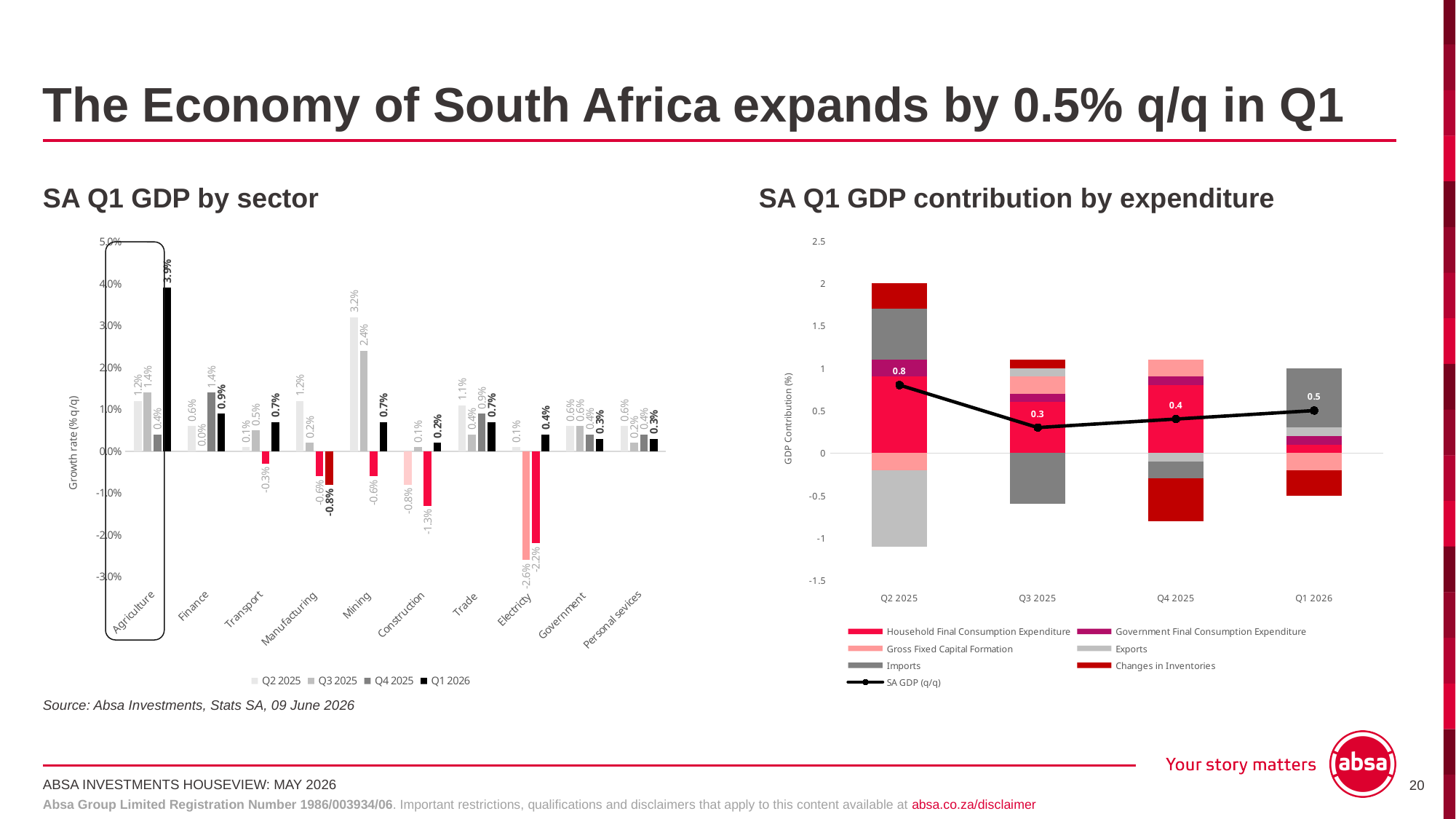
In the 'SA Q1 GDP by sector' chart, which sector has the lowest Q1 2026 growth rate? Manufacturing How many sectors are shown in the 'SA Q1 GDP by sector' chart? 10 In the 'SA Q1 GDP by sector' chart, which is larger for Construction: the Q2 2025 value or the Q4 2025 value? Q2 2025 How many entries does the legend of the 'SA Q1 GDP contribution by expenditure' chart list? 7 In the 'SA Q1 GDP by sector' chart, what is the Q1 2026 growth rate for Agriculture? 3.9% How many series does the legend of the 'SA Q1 GDP by sector' chart list? 4 In the 'SA Q1 GDP by sector' chart, what is the difference between the Q2 2025 and Q3 2025 growth rates for Mining? 0.8 percentage points In the 'SA Q1 GDP by sector' chart, which sector has the highest Q1 2026 growth rate? Agriculture What kind of chart is the 'SA Q1 GDP contribution by expenditure' chart? Stacked bar chart with a line In the 'SA Q1 GDP contribution by expenditure' chart, what is the SA GDP (q/q) value for Q3 2025? 0.3 In the 'SA Q1 GDP by sector' chart, what is the Q3 2025 growth rate for Electricity? -2.6% In the 'SA Q1 GDP contribution by expenditure' chart, which quarter has the highest SA GDP (q/q) value? Q2 2025